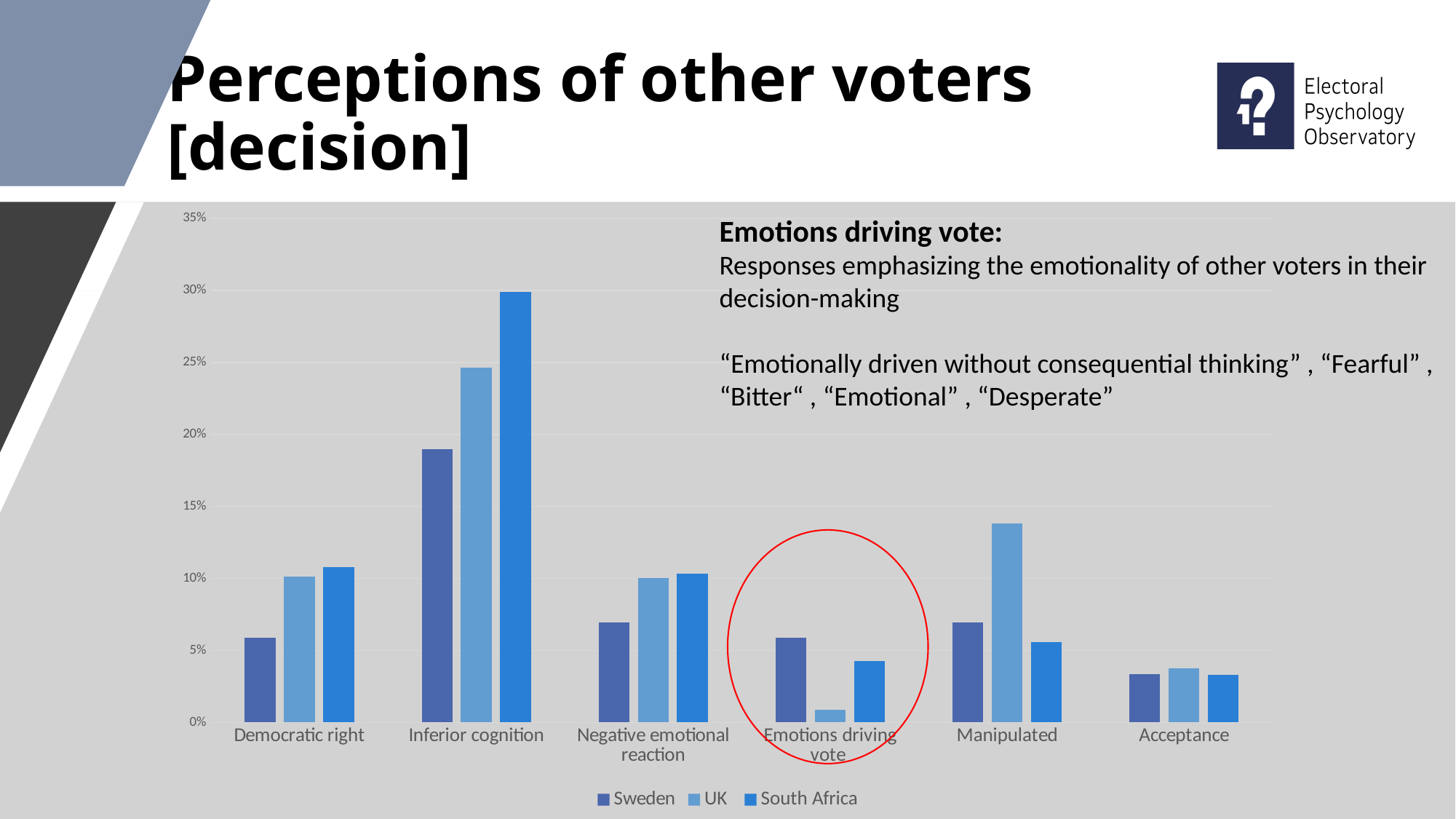
Is the value for the UK in the Emotions driving vote category greater or less than 5%? less How many categories are shown on the x axis of the chart? 6 Which series are listed in the chart's legend? Sweden, UK, South Africa Is the value for the UK in the Manipulated category greater or less than 10%? greater Is the value for Sweden in the Inferior cognition category greater or less than 20%? less What kind of chart is shown on the slide? bar chart In the Manipulated category, which is larger: the UK value or the South Africa value? UK How many series does the chart's legend list? 3 Which category on the chart is circled in red? Emotions driving vote Which category has the lowest bar for the UK? Emotions driving vote Which category has the highest bar for South Africa? Inferior cognition